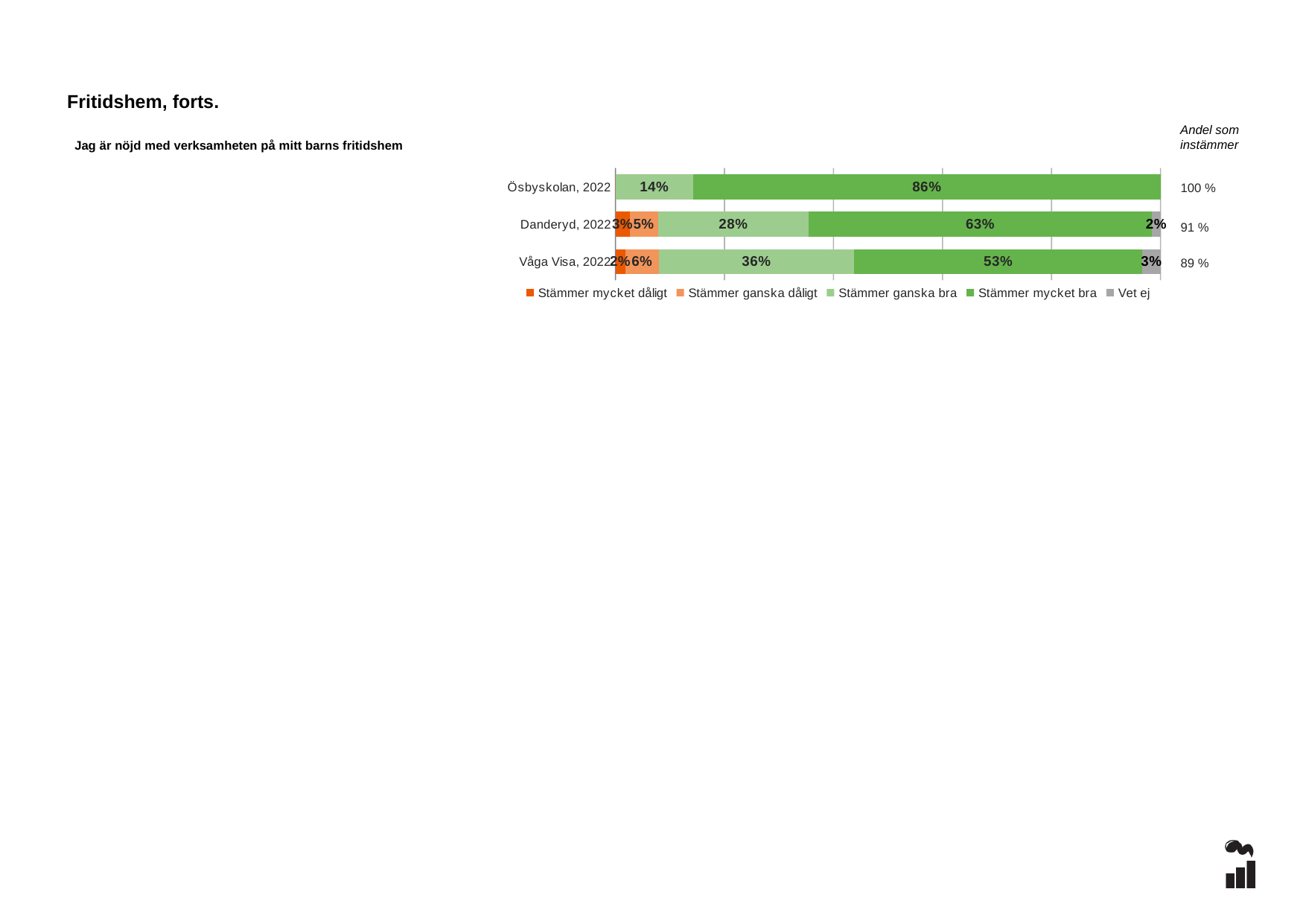
What is the difference between the "Stämmer mycket bra" values for Ösbyskolan, 2022 and Danderyd, 2022? 23 percentage points What is the "Stämmer mycket bra" value for Danderyd, 2022? 63% What is the "Vet ej" value for Våga Visa, 2022? 3% What is the "Andel som instämmer" value shown for Danderyd, 2022? 91 % Which category has the lowest "Stämmer mycket bra" value? Våga Visa, 2022 How many categories (bars) are shown in the chart? 3 What is the "Stämmer ganska bra" value for Våga Visa, 2022? 36% What kind of chart is shown on the slide? Stacked bar chart Which has a larger "Stämmer ganska bra" value, Danderyd, 2022 or Våga Visa, 2022? Våga Visa, 2022 How many series does the legend list? 5 Which category has the highest "Stämmer mycket bra" value? Ösbyskolan, 2022 What percentage of Ösbyskolan, 2022 respondents answered "Stämmer mycket bra"? 86%